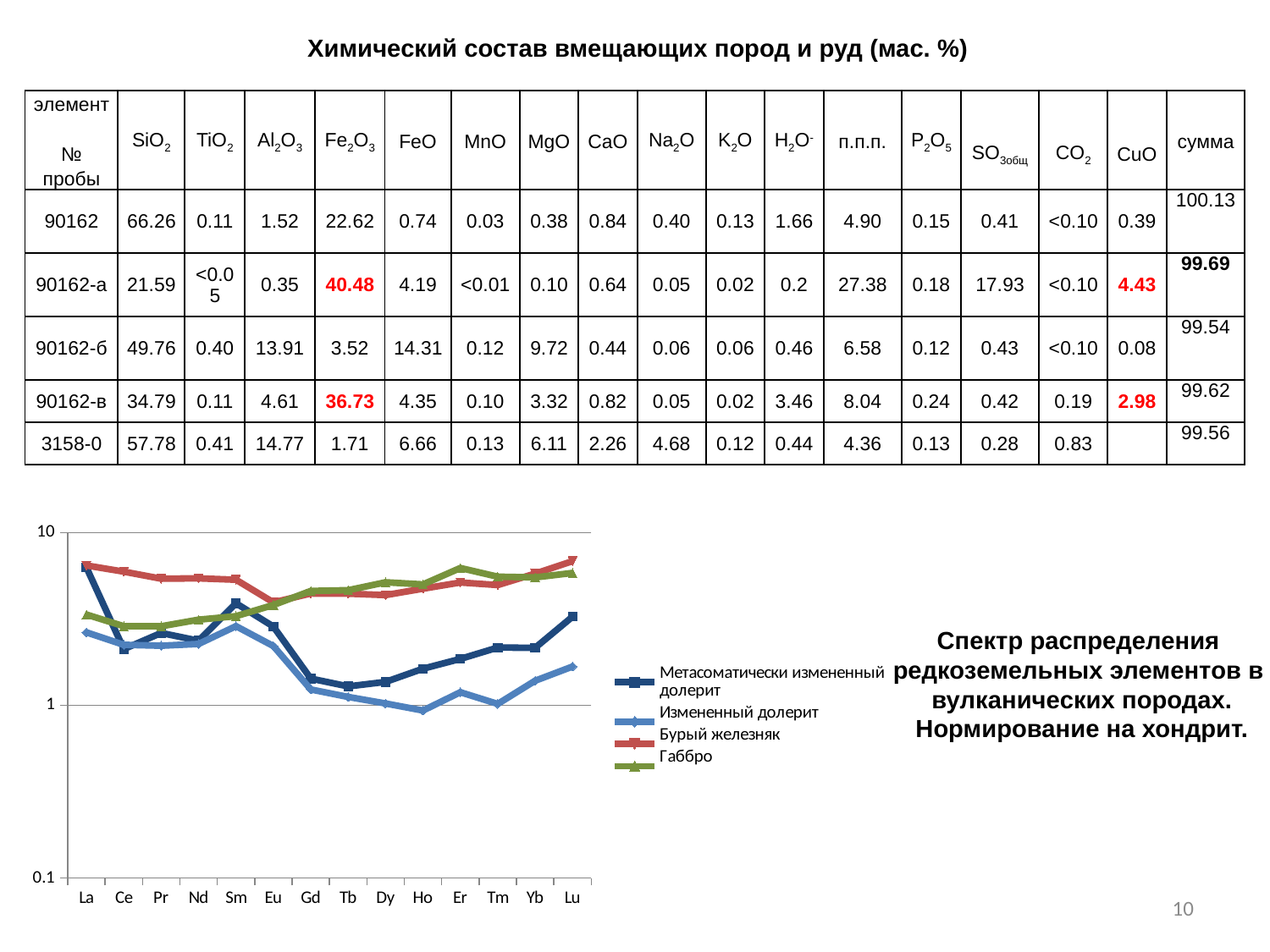
At Sm, which is larger: Метасоматически измененный долерит or Изменённый долерит? Метасоматически измененный долерит What kind of chart is shown on the slide? line chart At Lu, which is larger: Габбро or Изменённый долерит? Габбро Does the Изменённый долерит series rise or fall from La to Ho? fall Which series is listed first in the chart legend? Метасоматически измененный долерит What is the highest value shown on the chart's y axis? 10 How many categories are shown along the x axis of the chart? 14 How many series does the chart legend list? 4 Is the value for Габбро at Lu greater or less than 1? greater At La, which is larger: Бурый железняк or Изменённый долерит? Бурый железняк Is the value for Изменённый долерит at Gd greater or less than 10? less Is the value for Бурый железняк at La greater or less than 1? greater